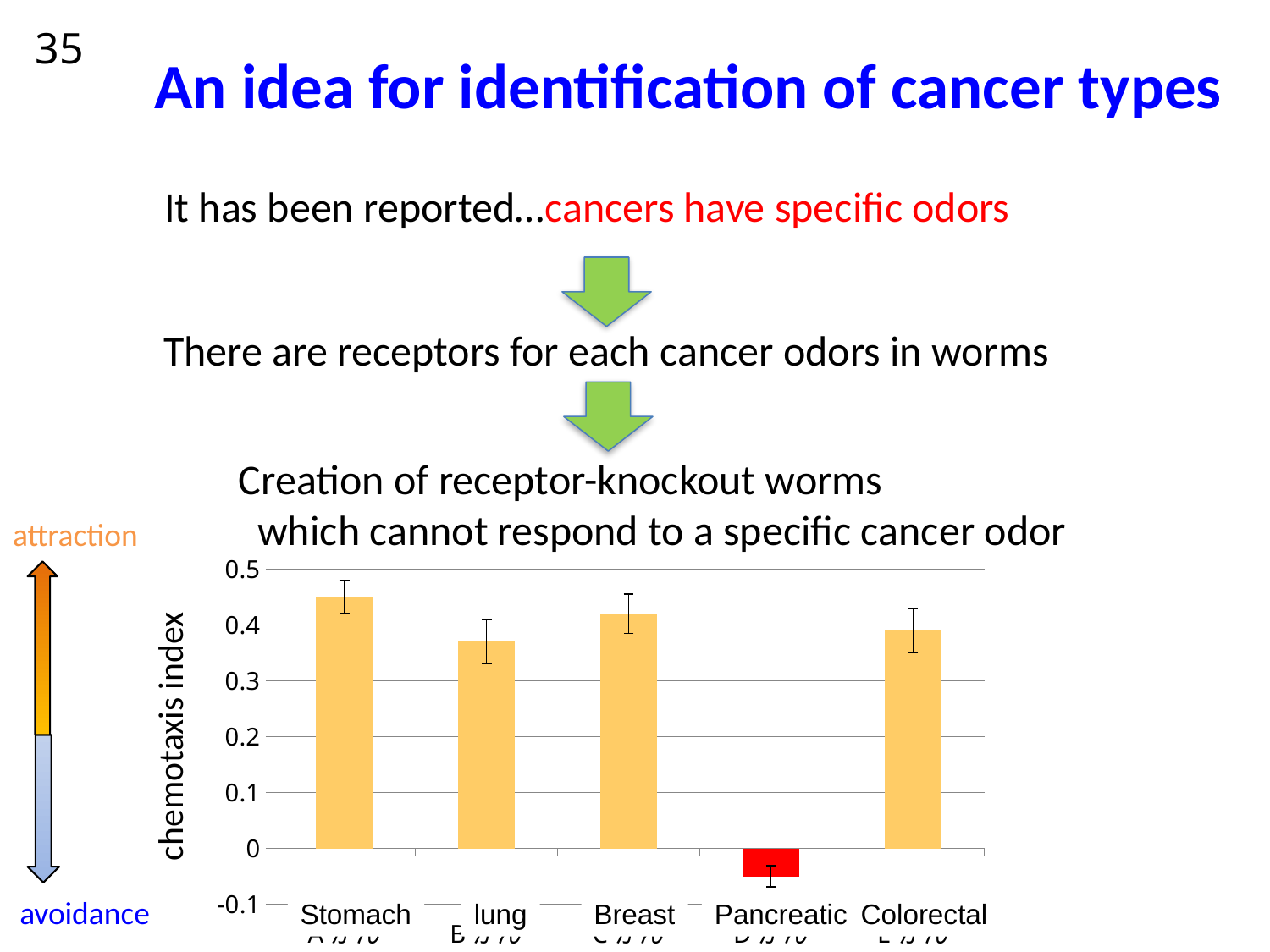
Is the chemotaxis index for lung greater or less than 0.4? less Which cancer type has the lowest chemotaxis index? Pancreatic Which cancer type's bar is coloured red on the chart? Pancreatic Which has a higher chemotaxis index, Stomach or lung? Stomach What is the label of the vertical axis of the chart? chemotaxis index Is the chemotaxis index for Pancreatic greater or less than 0? less Which has a higher chemotaxis index, Breast or Pancreatic? Breast Is the chemotaxis index for Stomach greater or less than 0.4? greater Which cancer type has the highest chemotaxis index? Stomach What kind of chart is shown on the slide? bar chart How many cancer types are plotted on the chart? 5